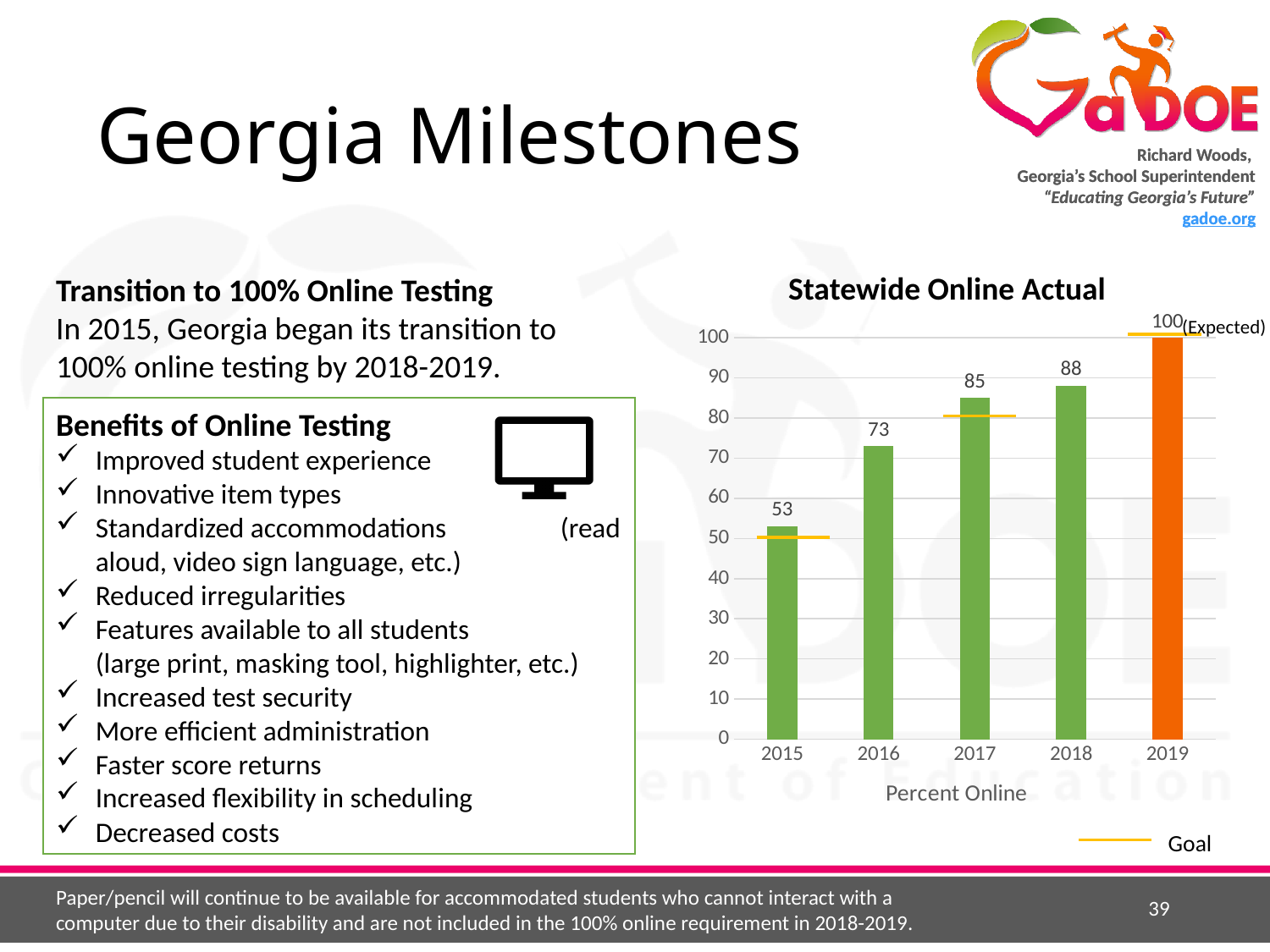
Which year has the lowest value in the Statewide Online Actual chart? 2015 How many years are shown on the x axis of the Statewide Online Actual chart? 5 What is the value for 2015 in the Statewide Online Actual chart? 53 Do the values in the Statewide Online Actual chart rise or fall from 2015 to 2019? rise What is the difference between the values for 2017 and 2016 in the Statewide Online Actual chart? 12 What is the difference between the values for 2019 and 2015 in the Statewide Online Actual chart? 47 Which is larger in the Statewide Online Actual chart, the value for 2017 or the value for 2018? 2018 What is the value for 2016 in the Statewide Online Actual chart? 73 What is the value for 2018 in the Statewide Online Actual chart? 88 What kind of chart is the Statewide Online Actual chart? bar chart Which year has the highest value in the Statewide Online Actual chart? 2019 What is the x-axis label of the Statewide Online Actual chart? Percent Online